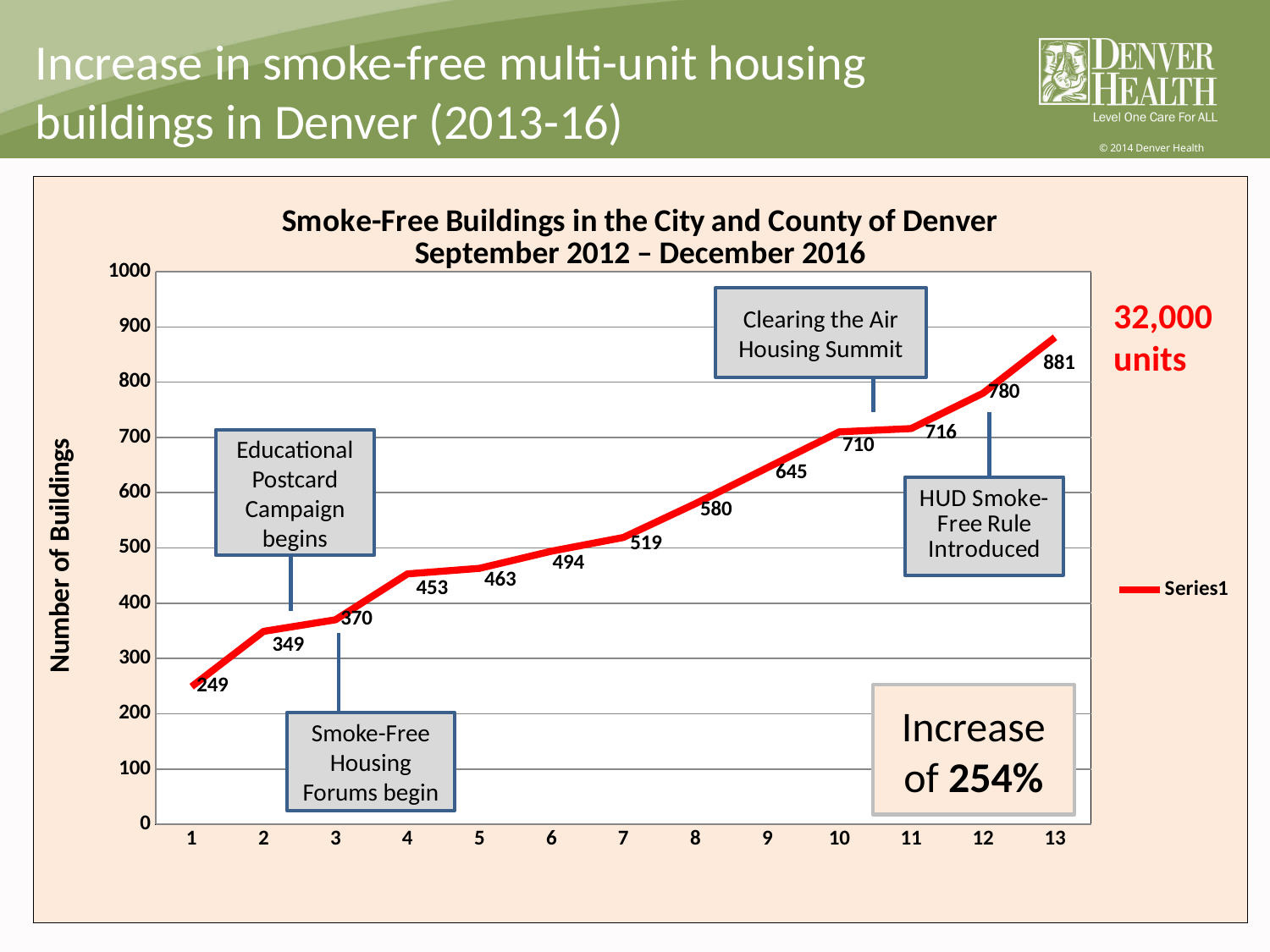
How many series does the legend list? 1 How many data points are plotted on the line? 13 What is the value at point 13 on the line chart? 881 What is the difference between the values at point 10 and point 9? 65 Which is larger, the value at point 4 or the value at point 5? point 5 What is the value at point 1 on the line chart? 249 What is the value at point 7 on the line chart? 519 Which point on the x axis has the highest number of buildings? 13 What kind of chart is shown on the slide? line chart Do the values rise or fall from point 1 to point 13? rise What is the difference between the values at point 13 and point 1? 632 Which point on the x axis has the lowest number of buildings? 1